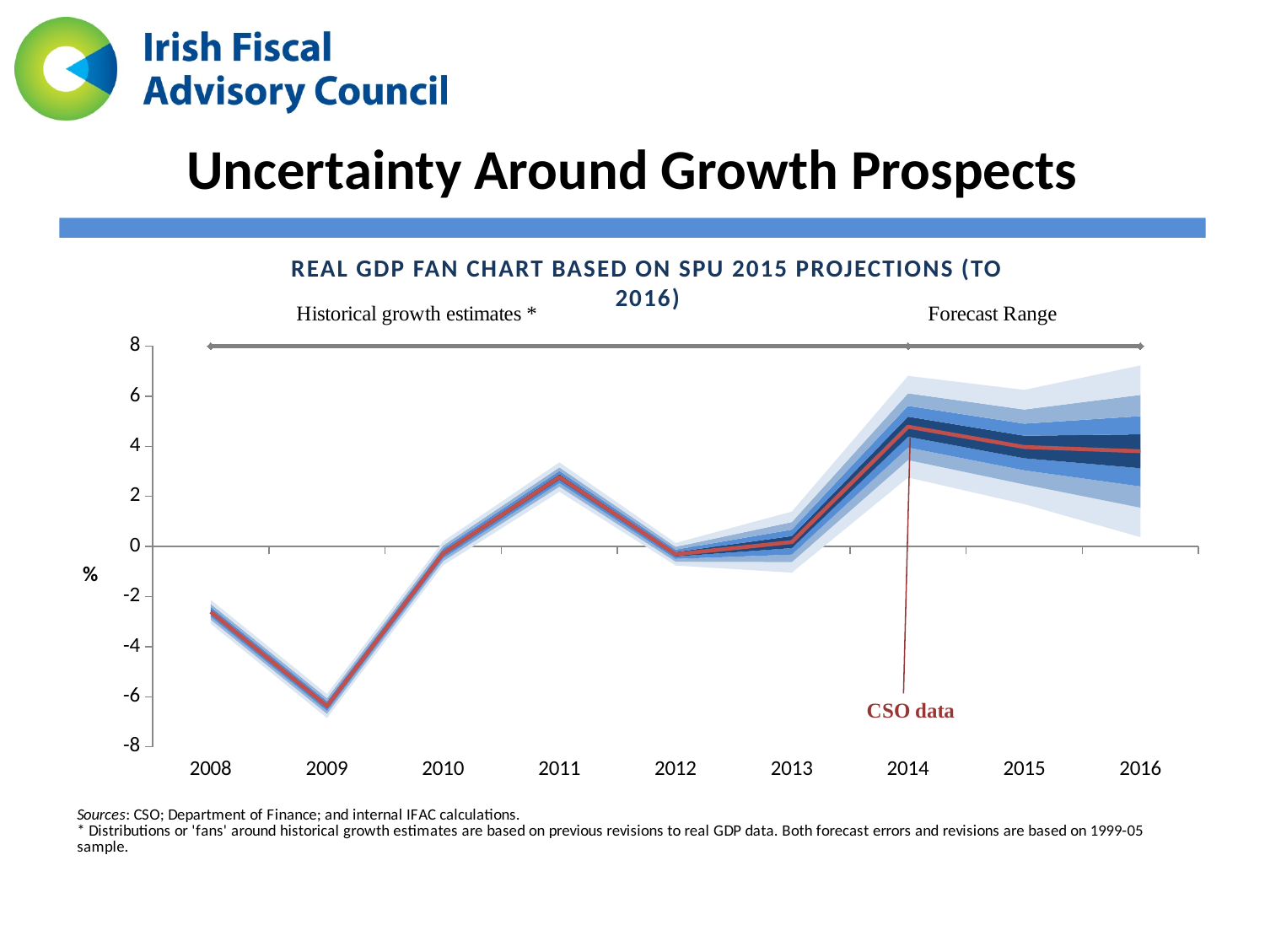
Is the central growth value for 2011 greater or less than 2? greater Does the central growth line rise or fall between 2009 and 2011? rise Which year is labelled with the annotation 'CSO data' on the chart? 2014 In which year does the central real GDP growth line reach its highest value? 2014 Is the central growth value for 2014 greater or less than 4? greater Is the central growth value for 2009 greater or less than -6? less How many years are shown along the x axis of the chart? 9 What kind of chart is shown on the slide? line chart (fan chart) What is the title of the chart? REAL GDP FAN CHART BASED ON SPU 2015 PROJECTIONS (TO 2016) Which year has the higher central growth value, 2011 or 2014? 2014 In which year does the central real GDP growth line reach its lowest value? 2009